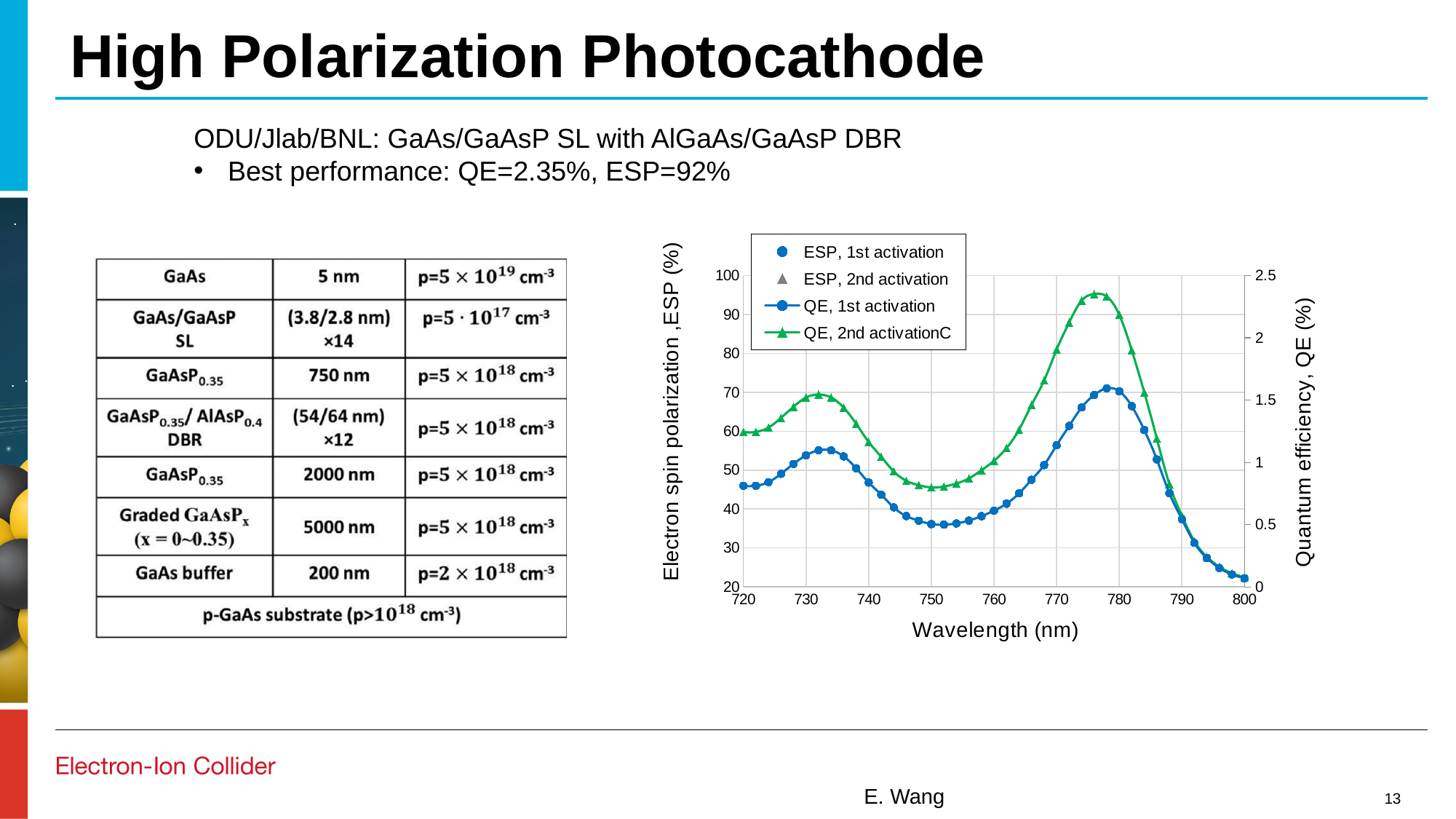
Between 760 nm and 775 nm, does the QE, 2nd activation series rise or fall as wavelength increases? rise At 750 nm, is the QE, 2nd activation value greater or less than 0.5 on the right-hand QE axis? greater Is the peak value of the QE, 2nd activation series greater or less than 2 on the right-hand QE axis? greater What is the label of the right-hand y axis of the chart? Quantum efficiency, QE (%) Is the peak value of the QE, 1st activation series greater or less than 1 on the right-hand QE axis? greater At 760 nm, which series has the larger value, QE, 1st activation or QE, 2nd activation? QE, 2nd activation What is the label of the x axis of the chart? Wavelength (nm) What kind of chart is shown on the slide? line chart Which series reaches the higher peak value, QE, 1st activation or QE, 2nd activation? QE, 2nd activation How many series does the chart's legend list? 4 Between 780 nm and 800 nm, do the QE values rise or fall as wavelength increases? fall